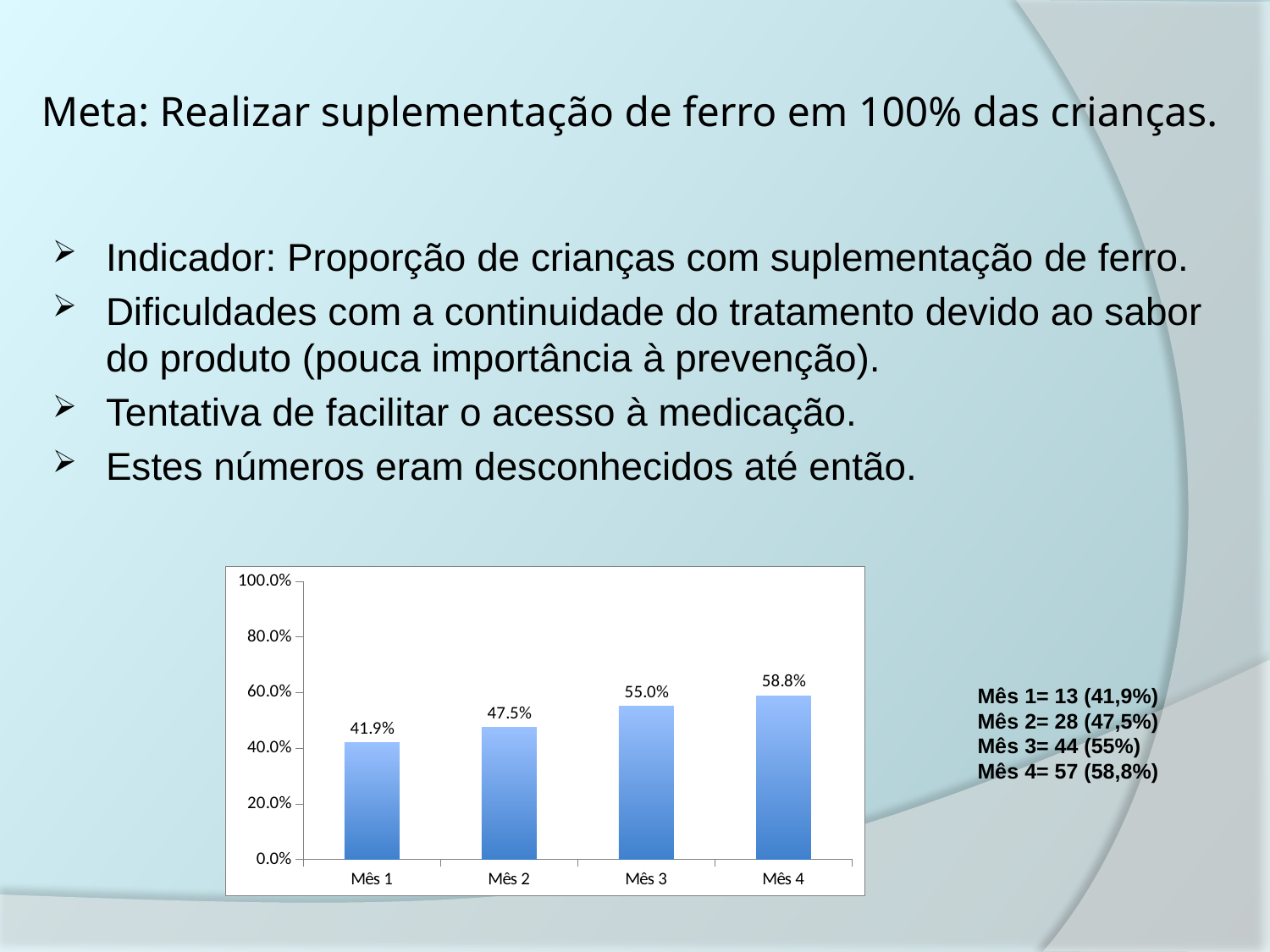
Which is larger, the value for Mês 2 or the value for Mês 3? Mês 3 What is the difference between the values for Mês 4 and Mês 1? 16.9% What is the value for Mês 3? 55.0% What is the value for Mês 1? 41.9% What is the difference between the values for Mês 3 and Mês 2? 7.5% What kind of chart is shown on the slide? bar chart Which month has the highest value? Mês 4 What is the value for Mês 4? 58.8% Is the value for Mês 4 greater or less than 60.0%? less How many categories are shown on the x axis? 4 Which month has the lowest value? Mês 1 Do the values rise or fall from Mês 1 to Mês 4? rise